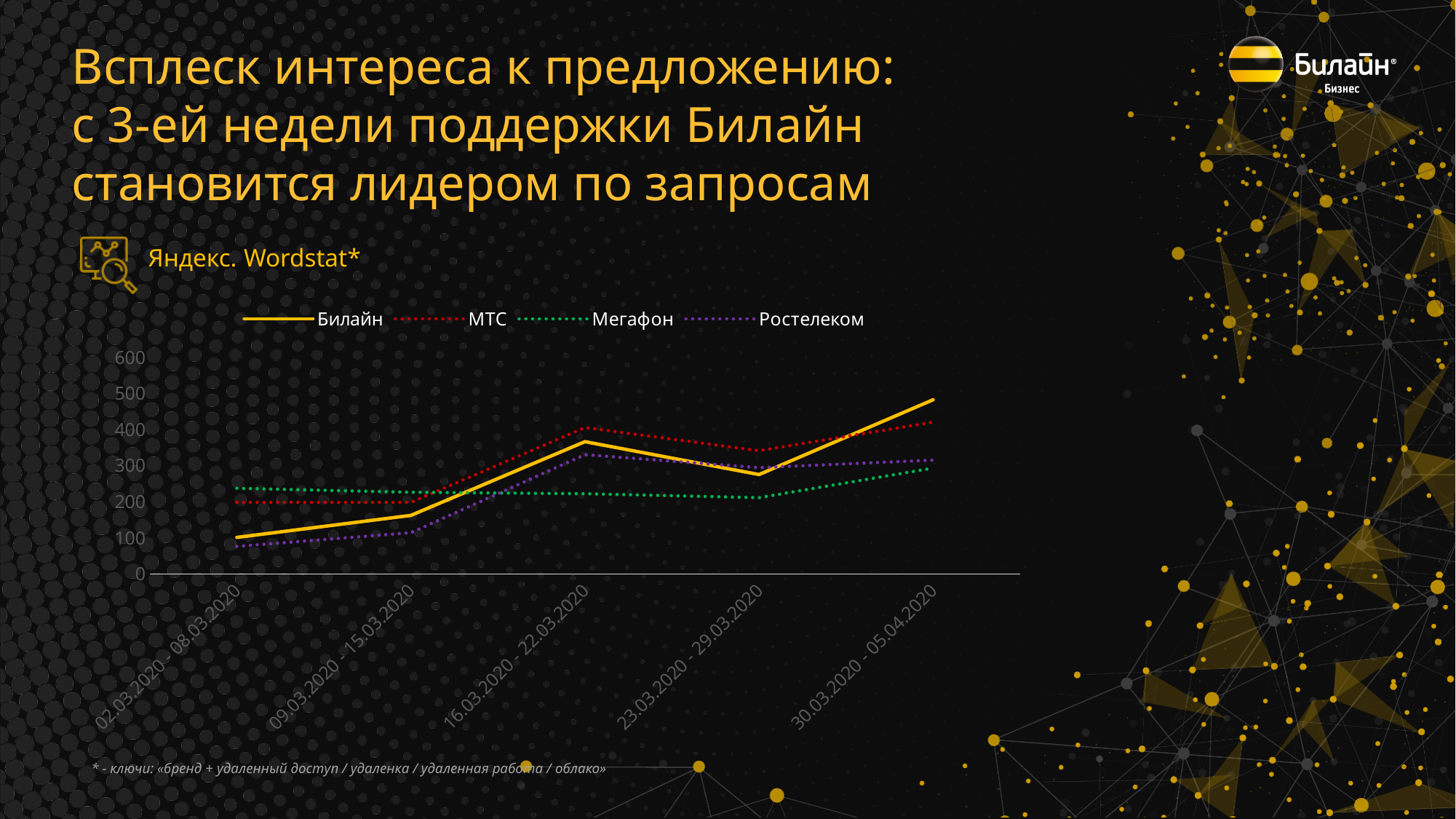
What kind of chart is shown on the slide? line chart Is the value for Билайн in the period 02.03.2020 - 08.03.2020 greater or less than 200? less Which series has the highest value in the period 02.03.2020 - 08.03.2020? Мегафон How many weekly periods are plotted along the x axis? 5 In the period 16.03.2020 - 22.03.2020, which is larger: the value for МТС or the value for Мегафон? МТС How many series does the legend list? 4 Is the value for Мегафон in the period 23.03.2020 - 29.03.2020 greater or less than 300? less Does the Билайн line rise or fall from the period 23.03.2020 - 29.03.2020 to the period 30.03.2020 - 05.04.2020? rise Is the value for Билайн in the period 30.03.2020 - 05.04.2020 greater or less than 400? greater What data source is named above the chart? Яндекс. Wordstat Which series is drawn as the solid yellow line? Билайн Which series has the highest value in the period 30.03.2020 - 05.04.2020? Билайн